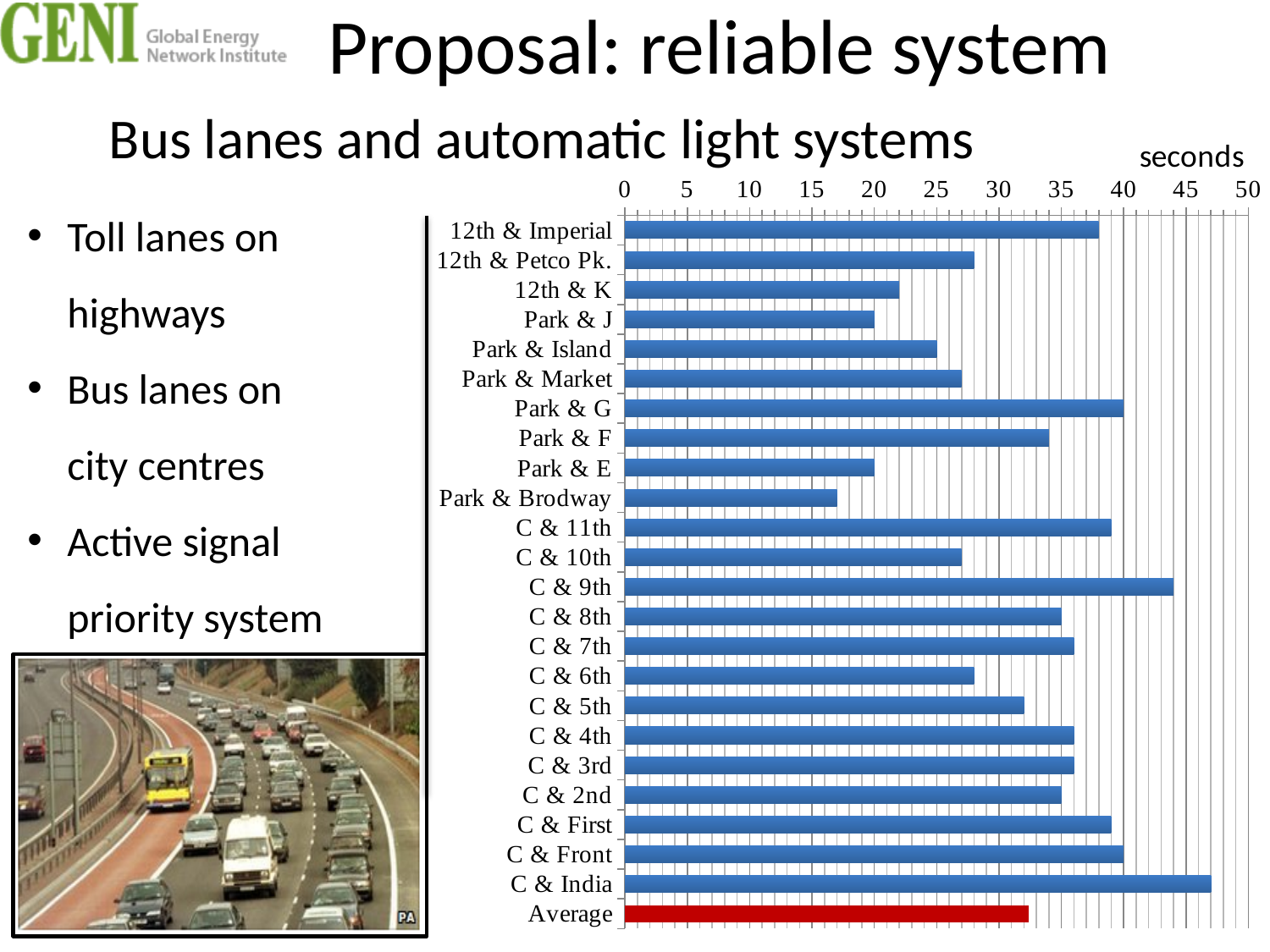
What kind of chart is shown on the slide? bar chart Which bar in the chart is coloured red instead of blue? Average Is the value for Park & Brodway greater or less than 20? less Which is larger, the value for C & 5th or the value for C & 6th? C & 5th Is the value for 12th & Imperial greater or less than 35? greater Which category has the lowest value in the chart? Park & Brodway Is the value for C & 9th greater or less than 40? greater What unit is shown above the chart's horizontal axis? seconds Which is larger, the value for Park & G or the value for Park & F? Park & G How many categories (bars) are shown in the chart? 24 Which category has the highest value in the chart? C & India